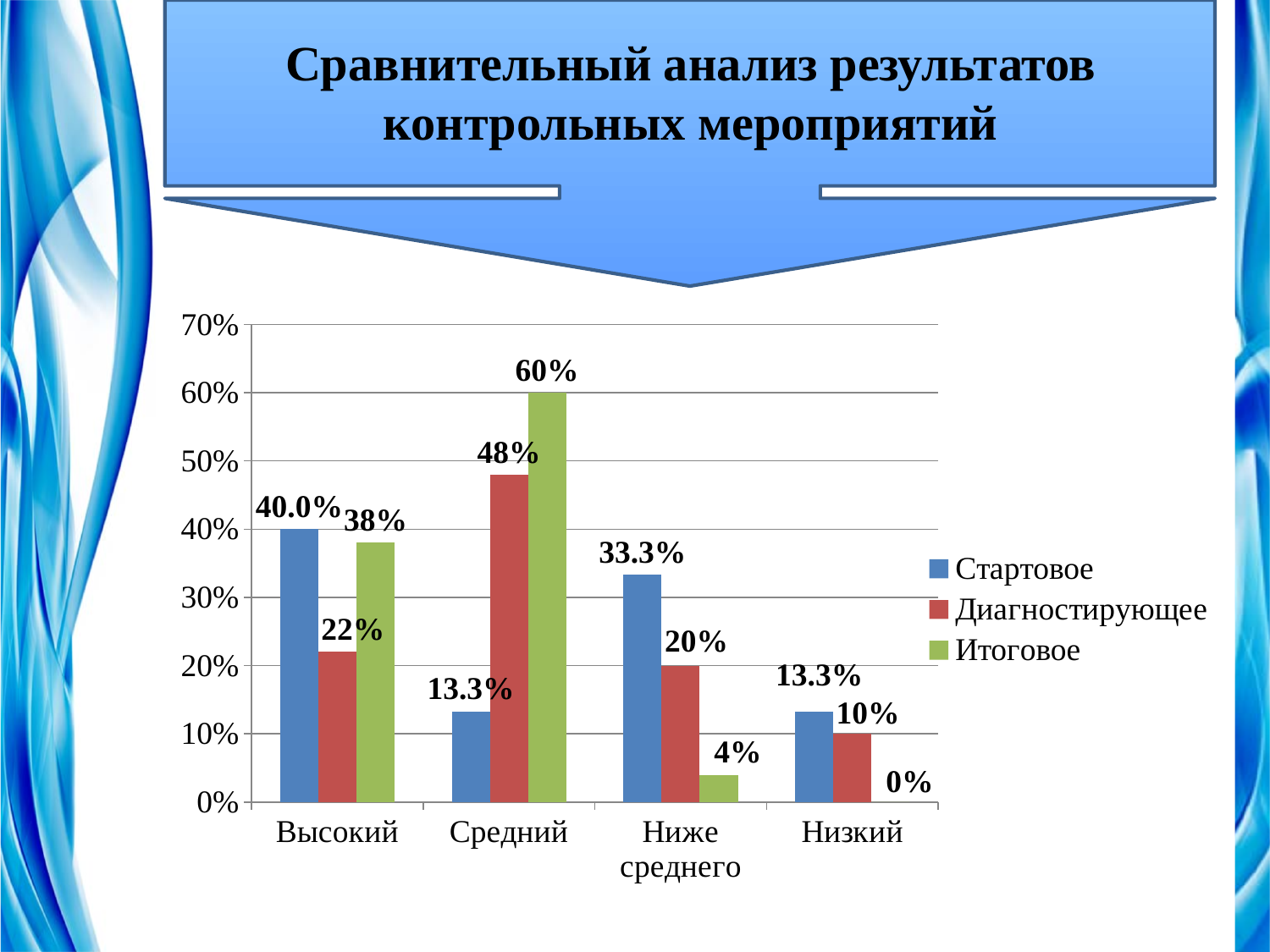
Which category has the highest value for the Итоговое series? Средний Which is larger in the Высокий category: the Стартовое value or the Итоговое value? Стартовое Which series is shown in green in the legend? Итоговое What kind of chart is shown on the slide? Bar chart What is the value for Итоговое in the Низкий category? 0% What is the difference between the Итоговое and Диагностирующее values in the Средний category? 12% What is the value for Итоговое in the Средний category? 60% What is the value for Диагностирующее in the Ниже среднего category? 20% What is the value for Стартовое in the Высокий category? 40.0% How many series does the legend list? 3 How many categories are shown on the x axis? 4 Which category has the lowest value for the Диагностирующее series? Низкий